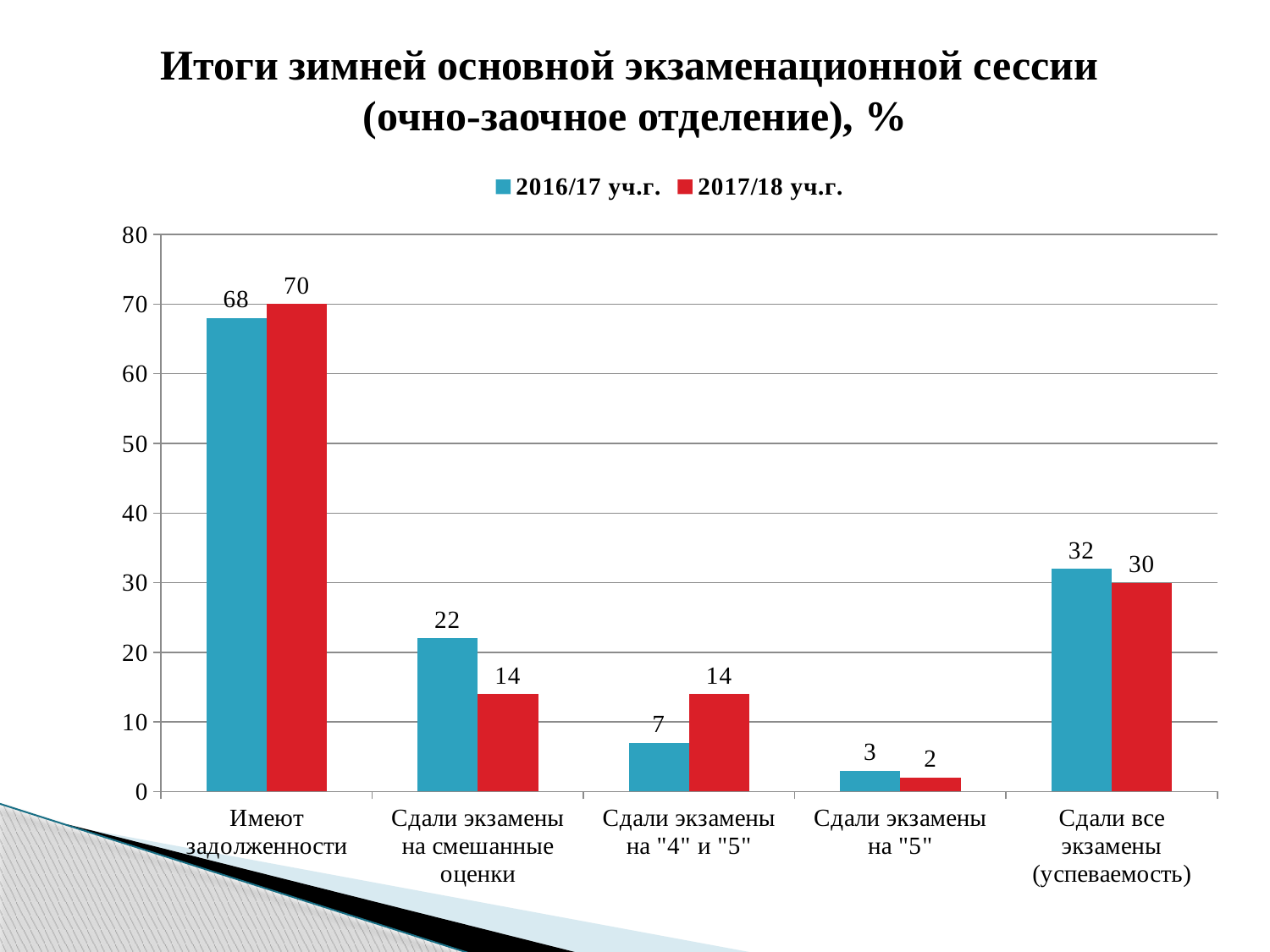
Which series has the larger value for "Сдали экзамены на "4" и "5""? 2017/18 уч.г. What is the difference between the 2016/17 уч.г. and 2017/18 уч.г. values for "Сдали экзамены на смешанные оценки"? 8 What is the value for "Сдали экзамены на смешанные оценки" in the 2016/17 уч.г. series? 22 How many categories are shown on the x axis? 5 What is the value for "Сдали экзамены на "5"" in the 2017/18 уч.г. series? 2 What colour represents the 2017/18 уч.г. series? red What is the value for "Имеют задолженности" in the 2017/18 уч.г. series? 70 Is the value for "Сдали все экзамены (успеваемость)" in the 2016/17 уч.г. series greater or less than 30? greater How many series does the legend list? 2 What kind of chart is shown on the slide? bar chart Which category has the lowest value in the 2017/18 уч.г. series? Сдали экзамены на "5" Which category has the highest value in the 2016/17 уч.г. series? Имеют задолженности